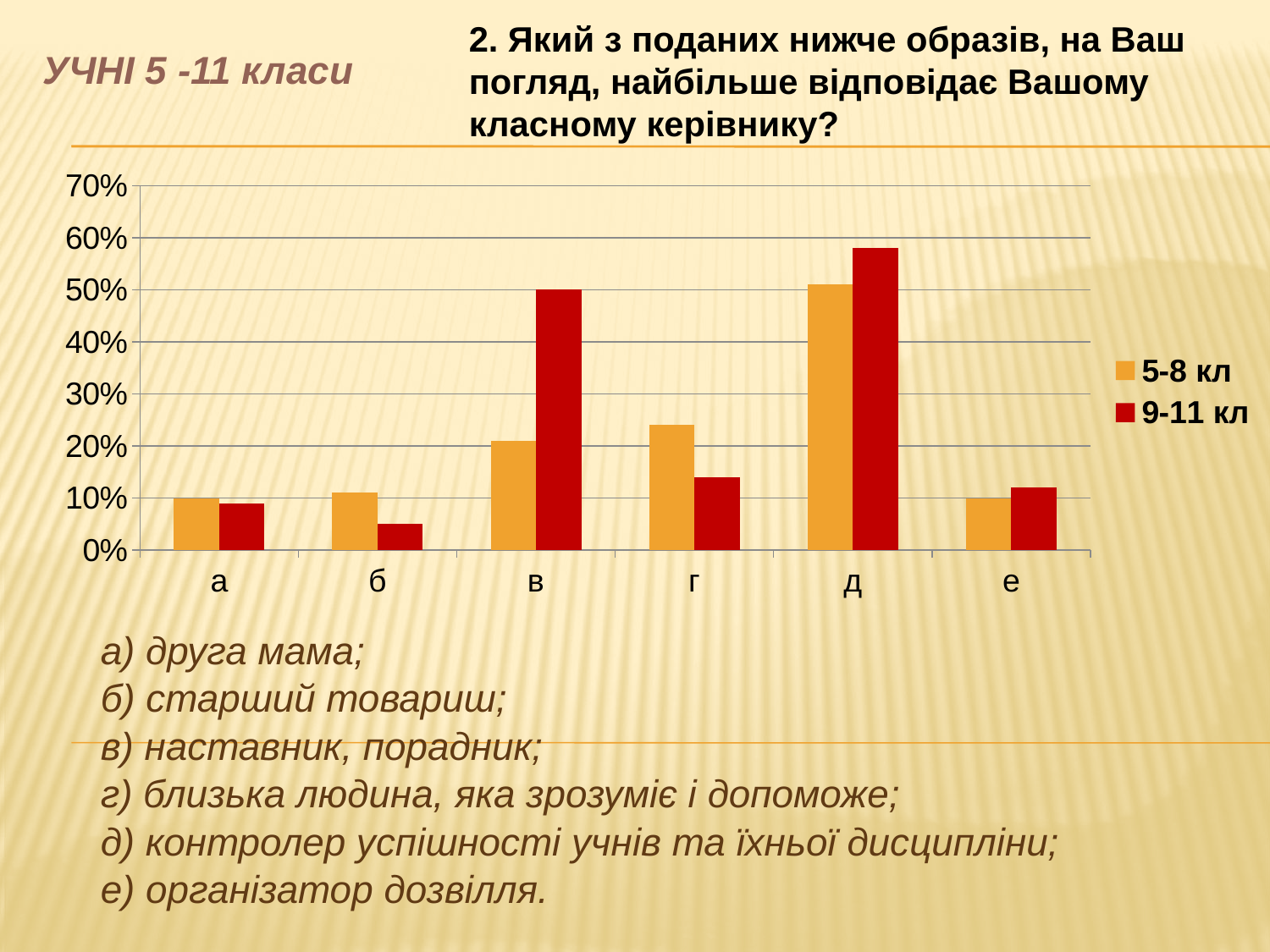
For category в, which series has the larger value, 5-8 кл or 9-11 кл? 9-11 кл What are the two series names listed in the legend? 5-8 кл and 9-11 кл For category г, which series has the larger value, 5-8 кл or 9-11 кл? 5-8 кл Which category has the lowest value for the 9-11 кл series? б Which category has the highest value for the 9-11 кл series? д Is the value for 5-8 кл in category в greater or less than 30%? less Is the value for 9-11 кл in category д greater or less than 50%? greater What kind of chart is shown on the slide? bar chart Is the value for 9-11 кл in category б greater or less than 10%? less How many categories are shown on the x axis of the chart? 6 How many series does the legend list? 2 Which category has the highest value for the 5-8 кл series? д